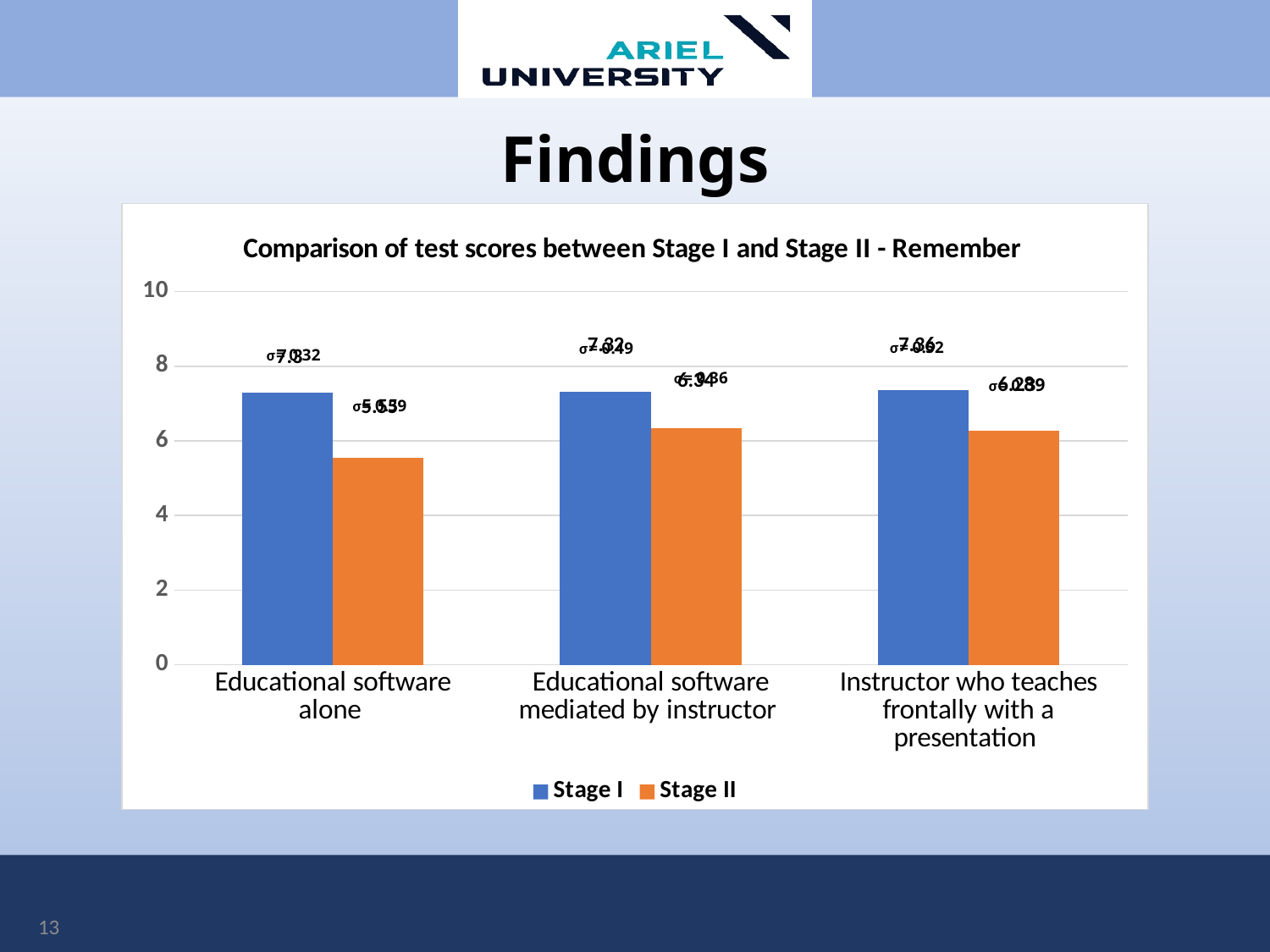
Is the Stage II value for 'Educational software mediated by instructor' greater or less than 6? greater Is the Stage II value for 'Educational software alone' greater or less than 6? less For 'Instructor who teaches frontally with a presentation', which is larger, Stage I or Stage II? Stage I What is the title of the chart? Comparison of test scores between Stage I and Stage II - Remember Which category has the lowest Stage II value? Educational software alone Which series is shown in orange? Stage II Is the Stage I value for 'Educational software mediated by instructor' greater or less than 8? less What kind of chart is shown on the slide? bar chart For 'Educational software alone', which is larger, Stage I or Stage II? Stage I How many series does the legend list? 2 How many categories are shown on the x axis? 3